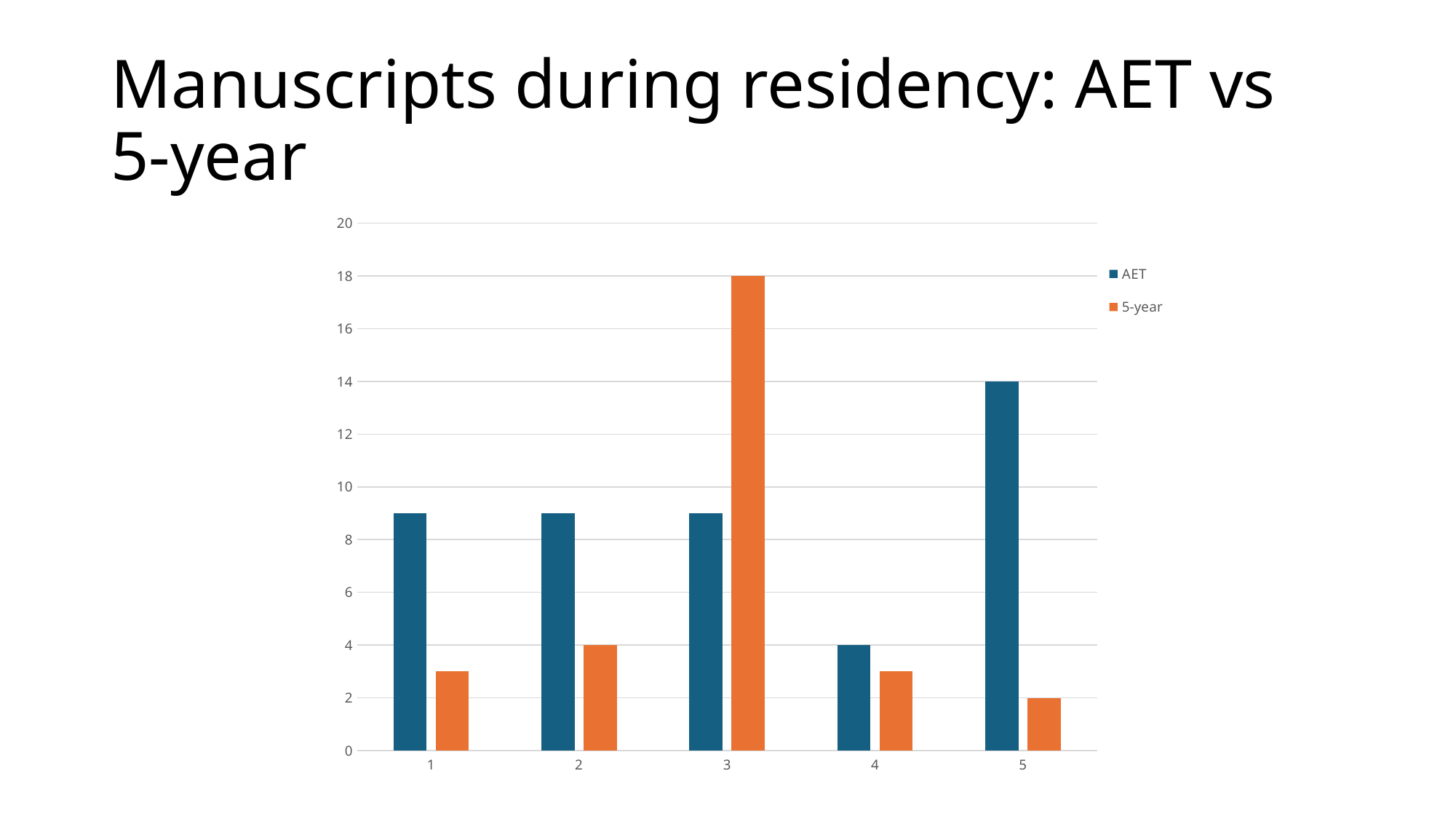
For which category is the AET value lowest? 4 What is the AET value for category 4? 4 For which category is the 5-year value highest? 3 How many series does the legend list? 2 What is the AET value for category 5? 14 What is the 5-year value for category 3? 18 What is the difference between the 5-year values for category 3 and category 5? 16 Is the AET value for category 1 greater or less than 6? greater How many categories are shown on the x axis? 5 For category 3, which series has the larger value, AET or 5-year? 5-year What type of chart is shown on the slide? bar chart What is the 5-year value for category 5? 2